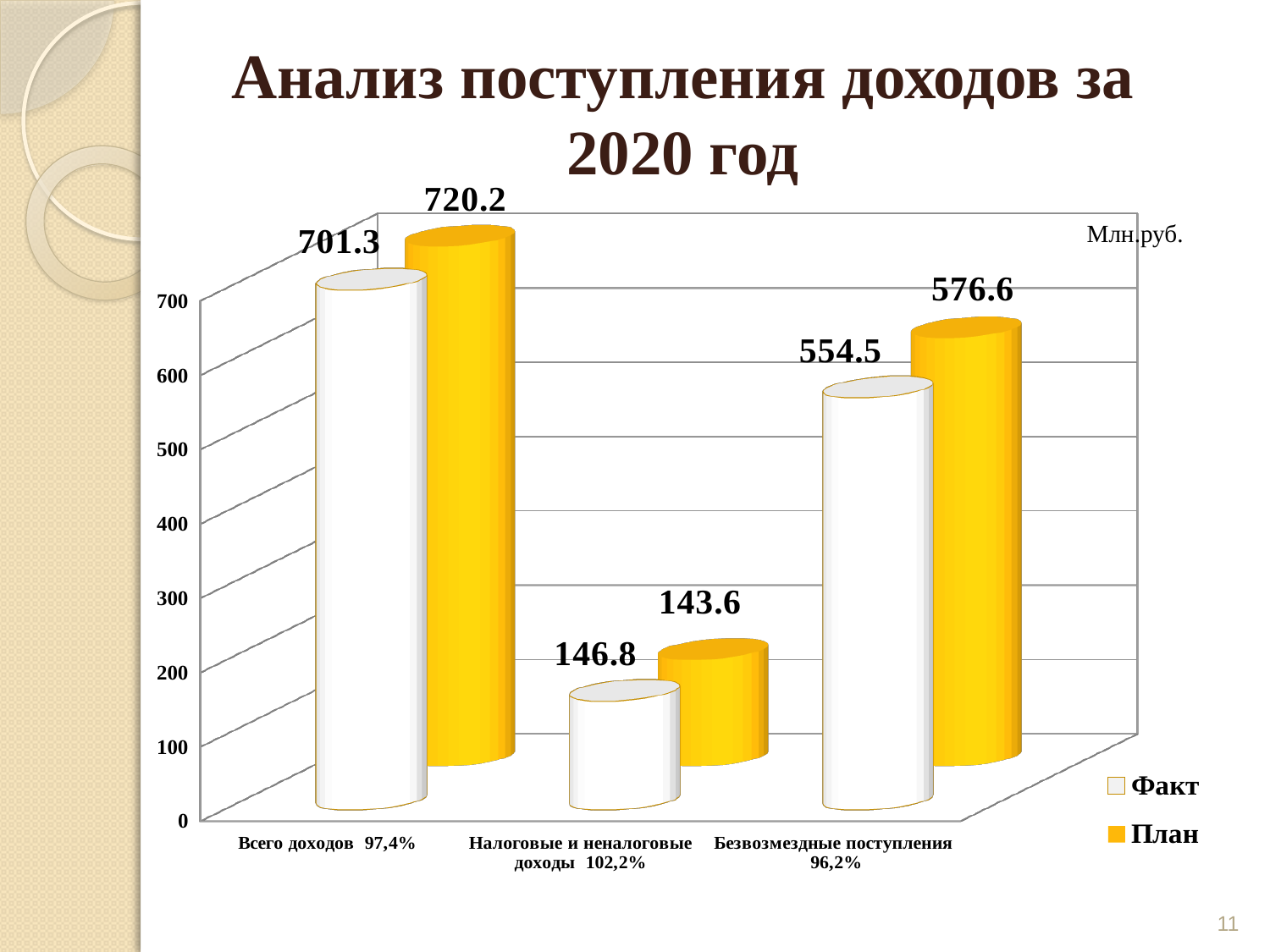
Which category has the lowest План value? Налоговые и неналоговые доходы For Налоговые и неналоговые доходы, which is larger: Факт or План? Факт How many series does the legend list? 2 What is the difference between the План and Факт values for Безвозмездные поступления? 22.1 Which category has the highest Факт value? Всего доходов What kind of chart is shown on the slide? Bar chart What is the Факт value for Налоговые и неналоговые доходы? 146.8 What is the Факт value for Всего доходов? 701.3 What is the difference between the План and Факт values for Всего доходов? 18.9 How many categories are shown on the x axis? 3 What is the План value for Всего доходов? 720.2 What is the План value for Безвозмездные поступления? 576.6